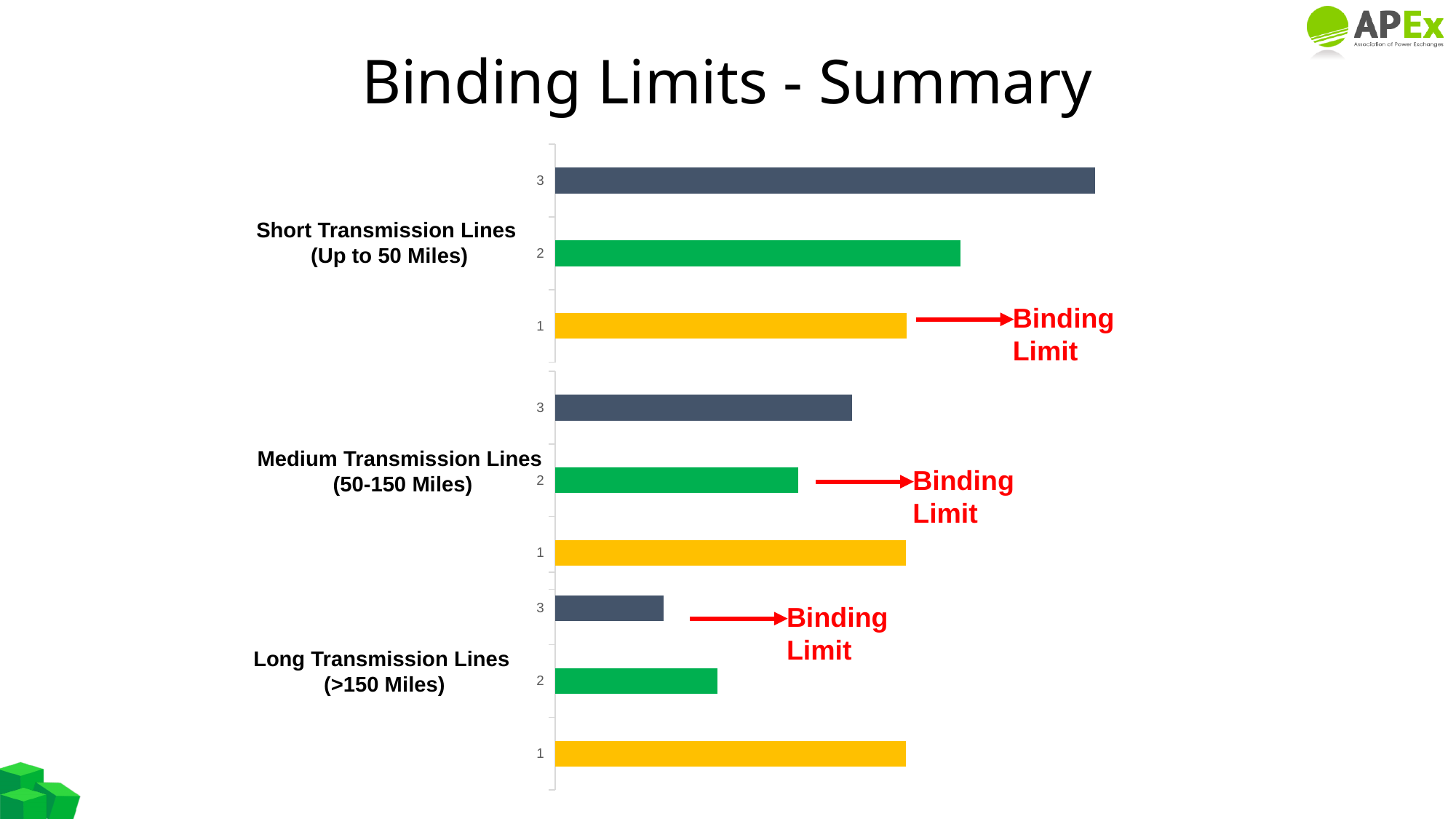
In the Long Transmission Lines (>150 Miles) chart, which category is labelled as the Binding Limit? 3 How many bars are shown in the Short Transmission Lines (Up to 50 Miles) chart? 3 In the Medium Transmission Lines (50-150 Miles) chart, which category has the shortest bar? 2 In the Long Transmission Lines (>150 Miles) chart, is the bar for category 2 longer or shorter than the bar for category 3? Longer In the Short Transmission Lines (Up to 50 Miles) chart, which category has the shortest bar? 1 What kind of chart is used for the Short Transmission Lines (Up to 50 Miles) data? Bar chart In the Short Transmission Lines (Up to 50 Miles) chart, which category is labelled as the Binding Limit? 1 In the Short Transmission Lines (Up to 50 Miles) chart, which category has the longest bar? 3 In the Long Transmission Lines (>150 Miles) chart, which category has the shortest bar? 3 In the Medium Transmission Lines (50-150 Miles) chart, which category has the longest bar? 1 In the Medium Transmission Lines (50-150 Miles) chart, is the bar for category 3 longer or shorter than the bar for category 1? Shorter In the Long Transmission Lines (>150 Miles) chart, which category has the longest bar? 1